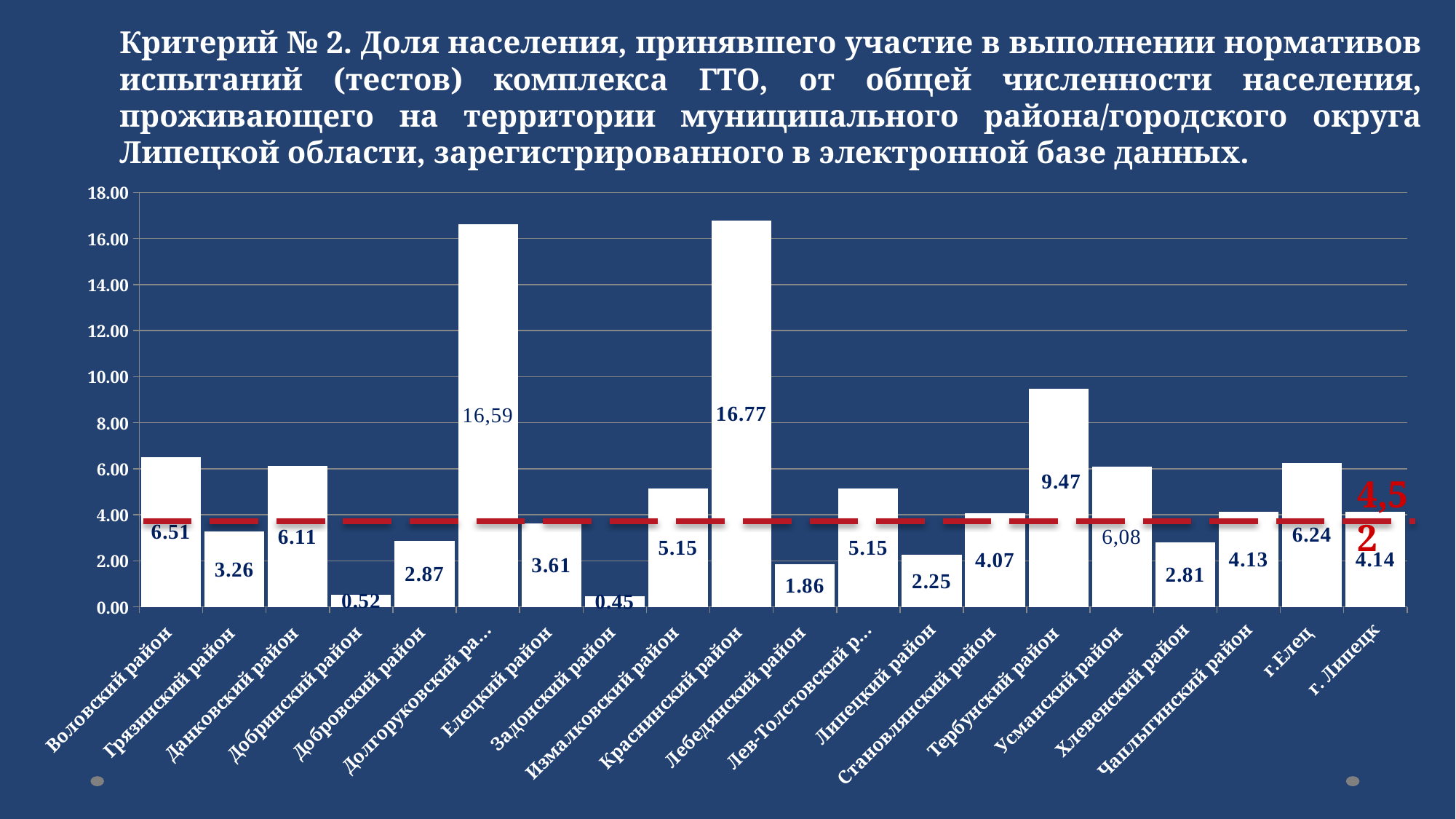
What is the difference between the values for г.Елец and г. Липецк? 2.10 How many categories are shown on the x axis? 20 Is the value for Тербунский район greater or less than 8.00? greater Which is larger, the value for Данковский район or the value for Добровский район? Данковский район What kind of chart is shown on the slide? bar chart Which category has the highest value? Краснинский район What is the value for Тербунский район? 9.47 What is the difference between the values for Воловский район and Грязинский район? 3.25 Is the value for Лебедянский район greater or less than 2.00? less What is the value for Воловский район? 6.51 What is the value for г. Липецк? 4.14 What is the value for Краснинский район? 16.77